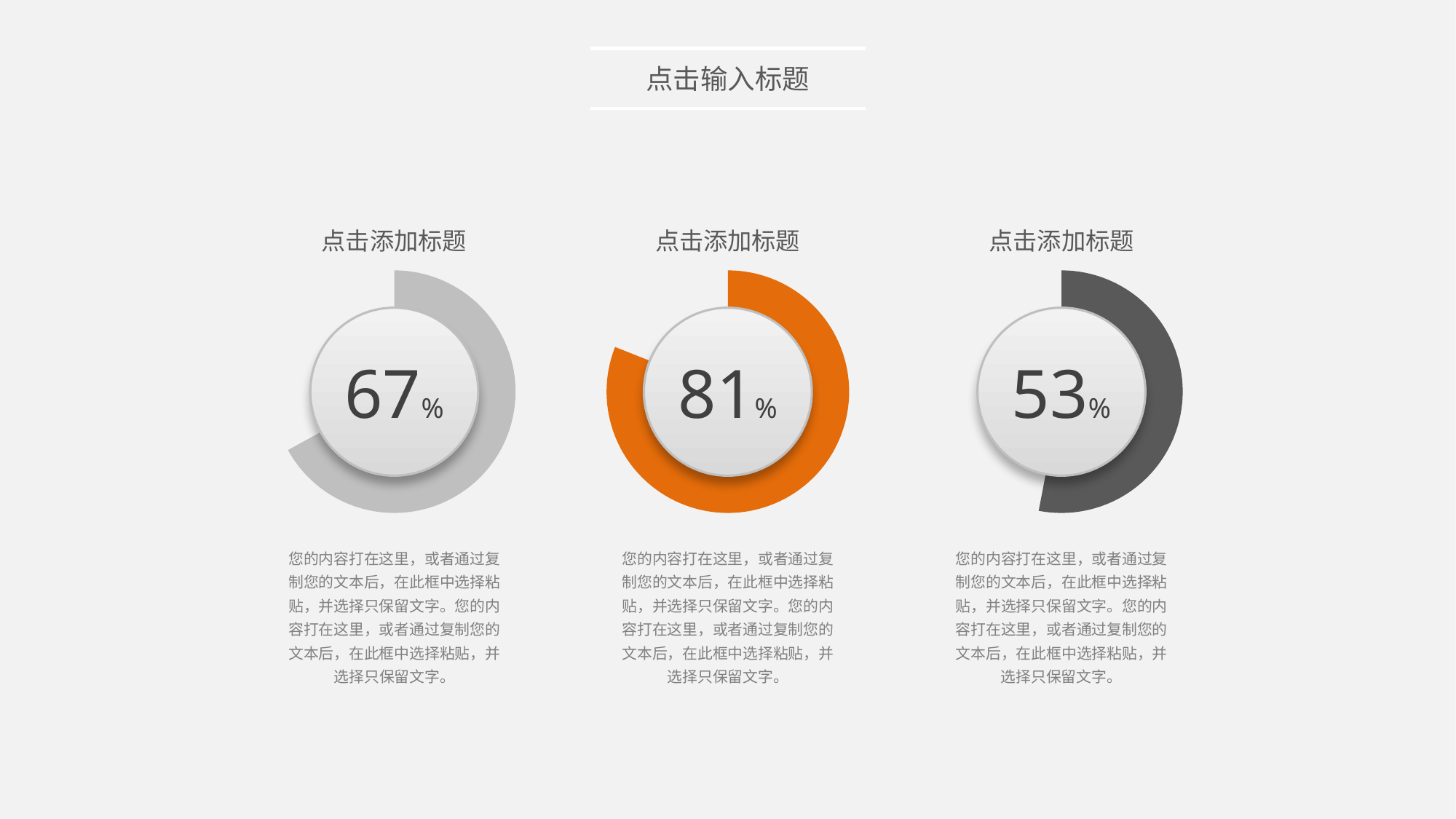
What value is shown in the right ring chart? 53% What kind of chart is used to display the percentages on the slide? Ring (donut) progress chart What value is shown in the middle ring chart? 81% Which of the three ring charts shows the lowest percentage? The right chart (53%) What is the difference between the left chart's value and the right chart's value? 14% How many ring charts are shown on the slide? 3 What colour is the ring of the middle chart? Orange What value is shown in the left ring chart? 67% Which is larger, the value in the left chart or the value in the right chart? The left chart (67%) What is the difference between the middle chart's value and the left chart's value? 14% What colour is the ring of the right chart? Dark grey Which of the three ring charts shows the highest percentage? The middle chart (81%)